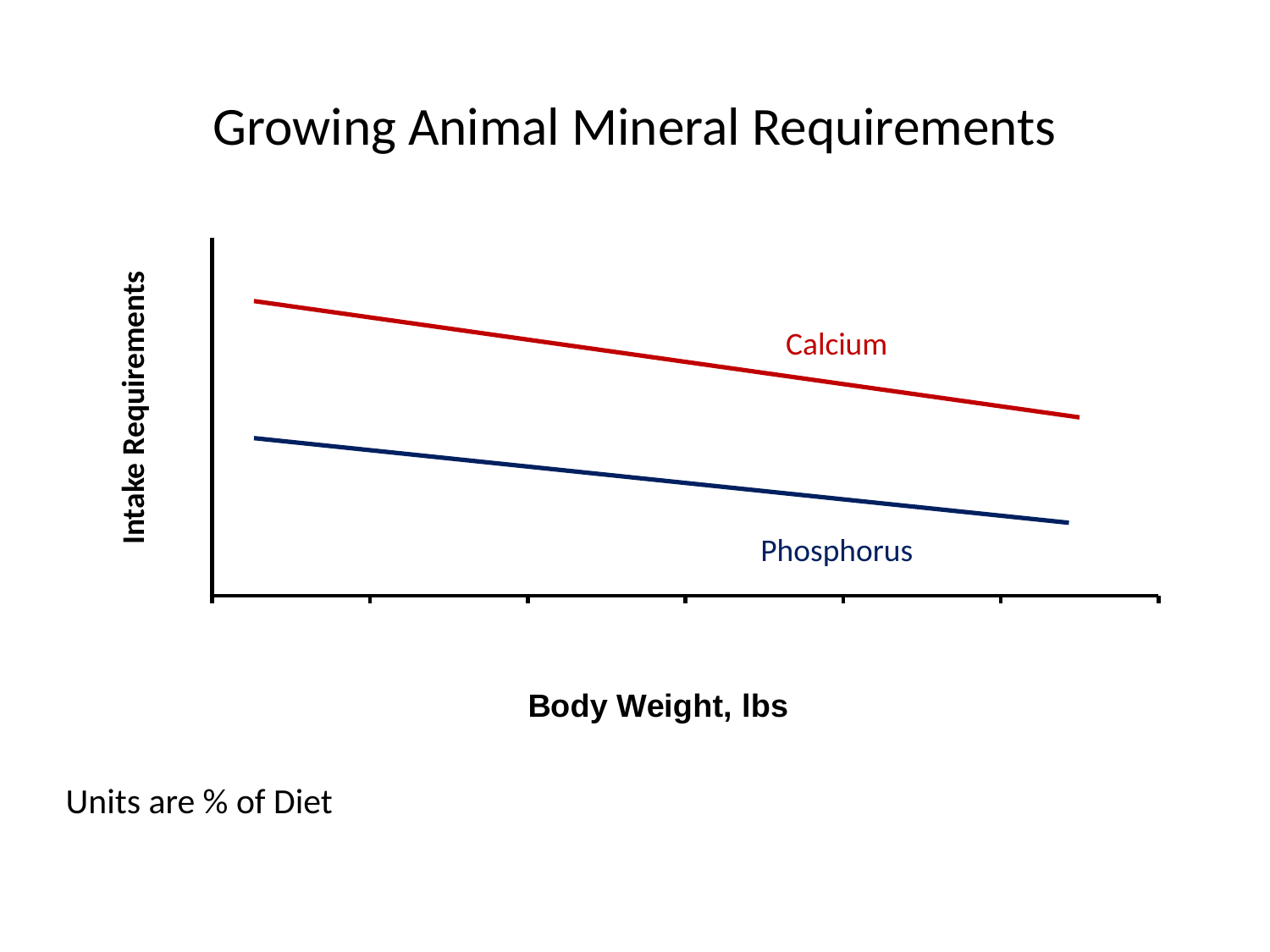
Which series has the lower intake requirement, Calcium or Phosphorus? Phosphorus Which series has the higher intake requirement across the range of body weights, Calcium or Phosphorus? Calcium How many series are plotted on the chart? 2 What is the label of the x axis? Body Weight, lbs What colour is the Calcium line? Red What kind of chart is shown on the slide? Line chart What is the title of the chart? Growing Animal Mineral Requirements Does the Calcium requirement rise or fall as body weight increases? Fall Does the Phosphorus requirement rise or fall as body weight increases? Fall